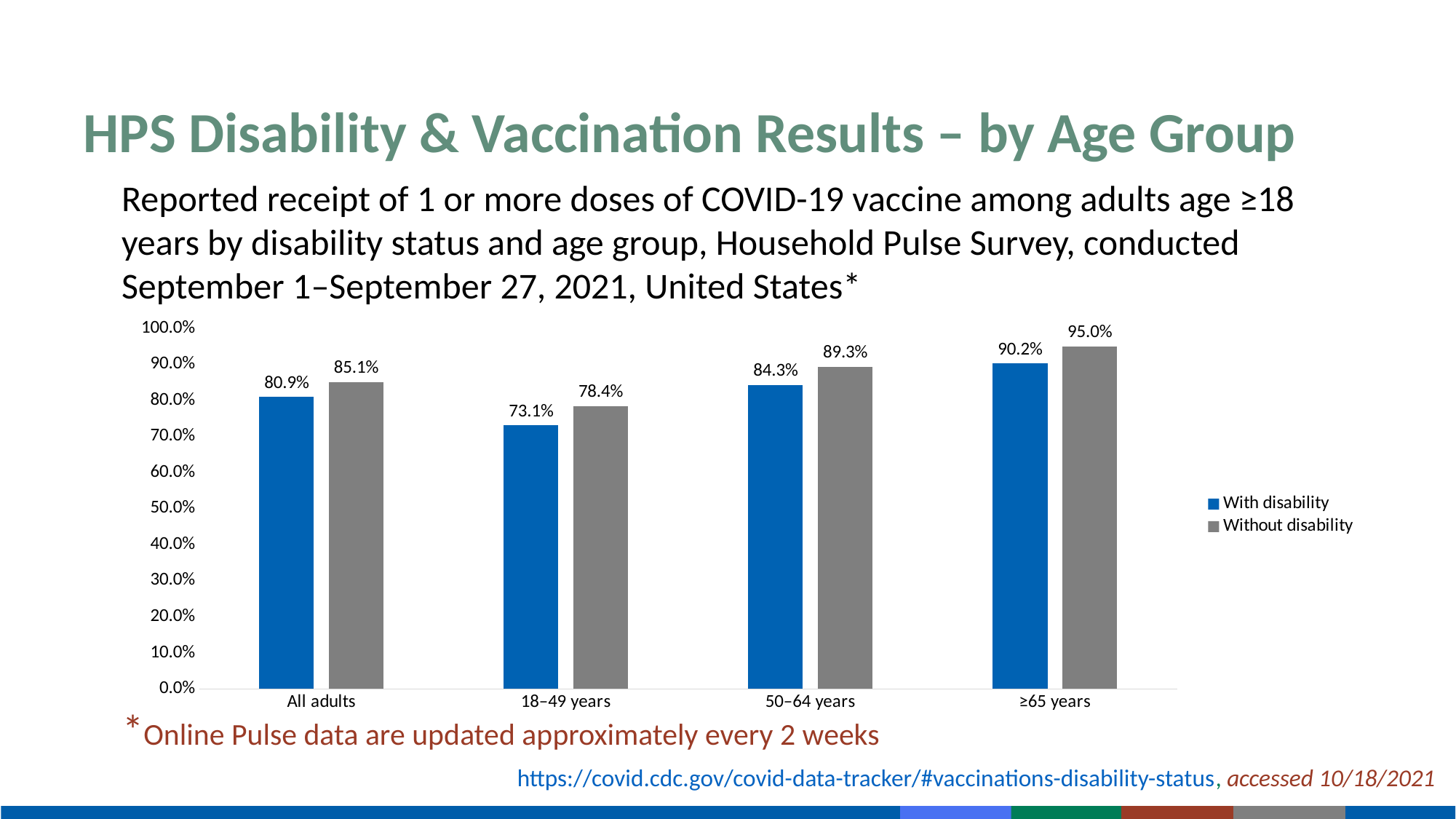
How many series does the legend list? 2 What is the value for 'With disability' in the 18–49 years group? 73.1% Which is larger in the 18–49 years group: 'With disability' or 'Without disability'? Without disability What is the difference between 'Without disability' and 'With disability' in the 50–64 years group? 5.0% Which age group has the highest value for 'Without disability'? ≥65 years What is the value for 'With disability' among All adults? 80.9% What kind of chart is shown on the slide? Bar chart Which age group has the lowest value for 'With disability'? 18–49 years How many categories are shown on the x axis? 4 Is the value for 'With disability' in the ≥65 years group greater or less than 80.0%? greater Which colour represents 'With disability' in the chart? Blue What is the value for 'Without disability' in the ≥65 years group? 95.0%